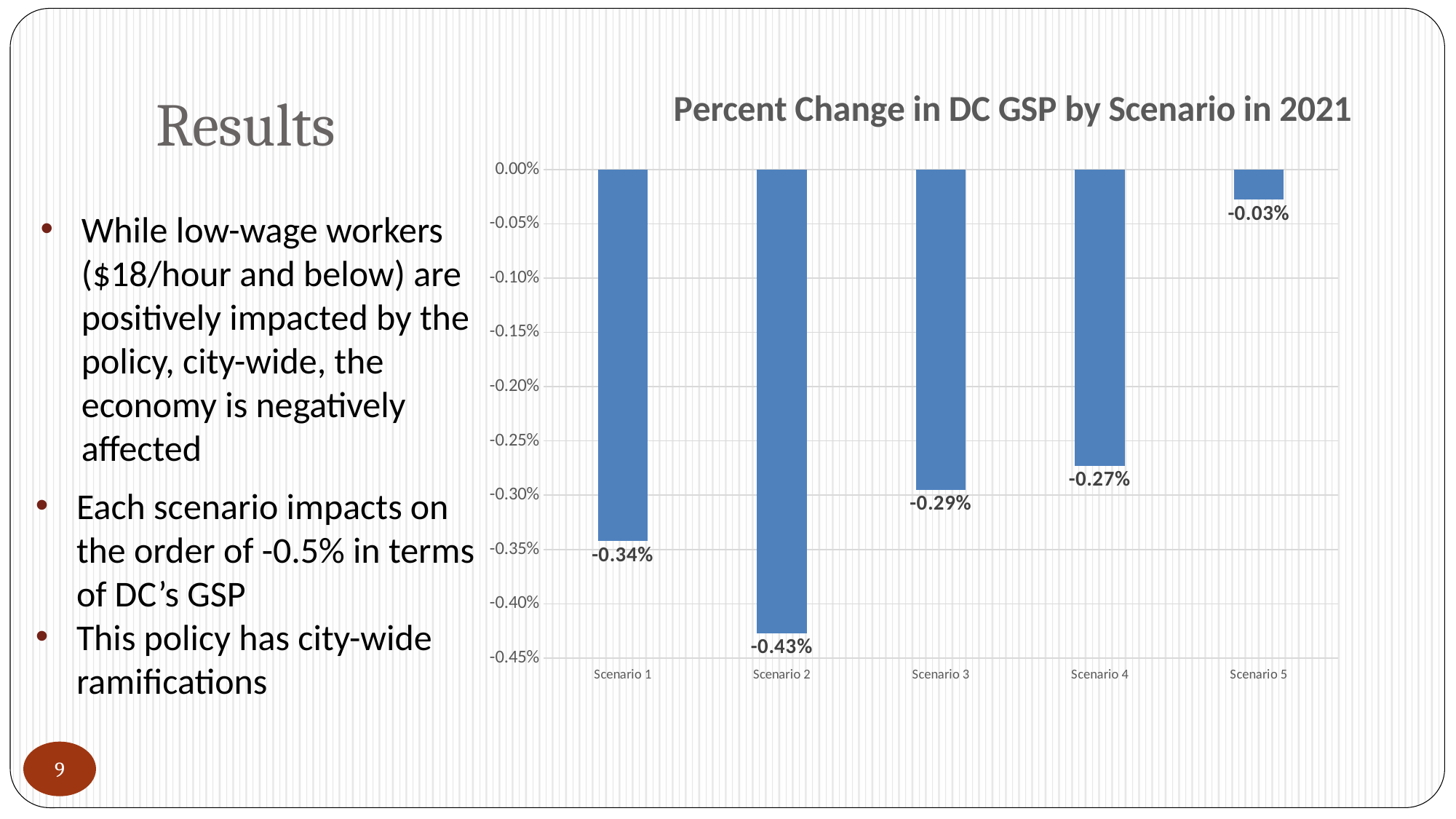
What is the title of the chart? Percent Change in DC GSP by Scenario in 2021 What is the percent change in DC GSP for Scenario 2? -0.43% What is the lowest value shown on the vertical axis? -0.45% Which scenario has the largest negative percent change in DC GSP? Scenario 2 How many scenarios are shown in the chart? 5 What type of chart is used to show the percent change in DC GSP? bar chart Which scenario has the smallest change in DC GSP (closest to zero)? Scenario 5 What is the difference between the values for Scenario 1 and Scenario 3? 0.05% What is the percent change in DC GSP for Scenario 5? -0.03% What is the value shown for Scenario 4? -0.27% Is the value for Scenario 3 above or below -0.30% on the axis? above Which has a larger negative change in DC GSP, Scenario 1 or Scenario 4? Scenario 1